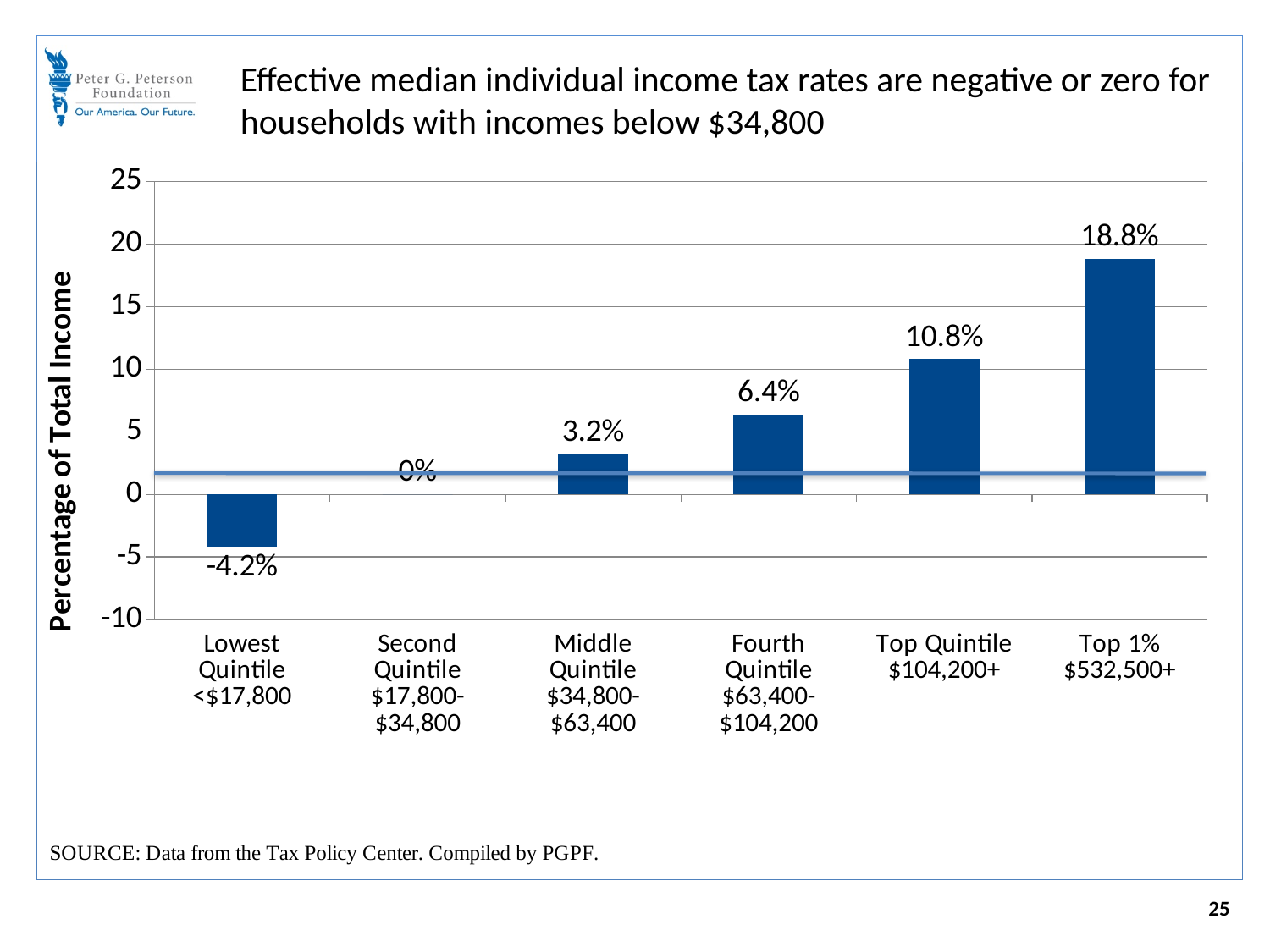
How many categories are shown on the x axis? 6 Is the value for the Top Quintile greater or less than 10? greater What kind of chart is shown? Bar chart What is the value shown for the Lowest Quintile? -4.2% Do the values rise or fall moving from the Lowest Quintile to the Top 1%? Rise Which category has the highest value? Top 1% What is the difference between the Top 1% and the Top Quintile values? 8 percentage points Which is larger, the value for the Fourth Quintile or the Middle Quintile? Fourth Quintile What is the value shown for the Middle Quintile? 3.2% What is the effective median income tax rate for the Top 1%? 18.8% What is the value shown for the Second Quintile? 0% Which category has the lowest value? Lowest Quintile